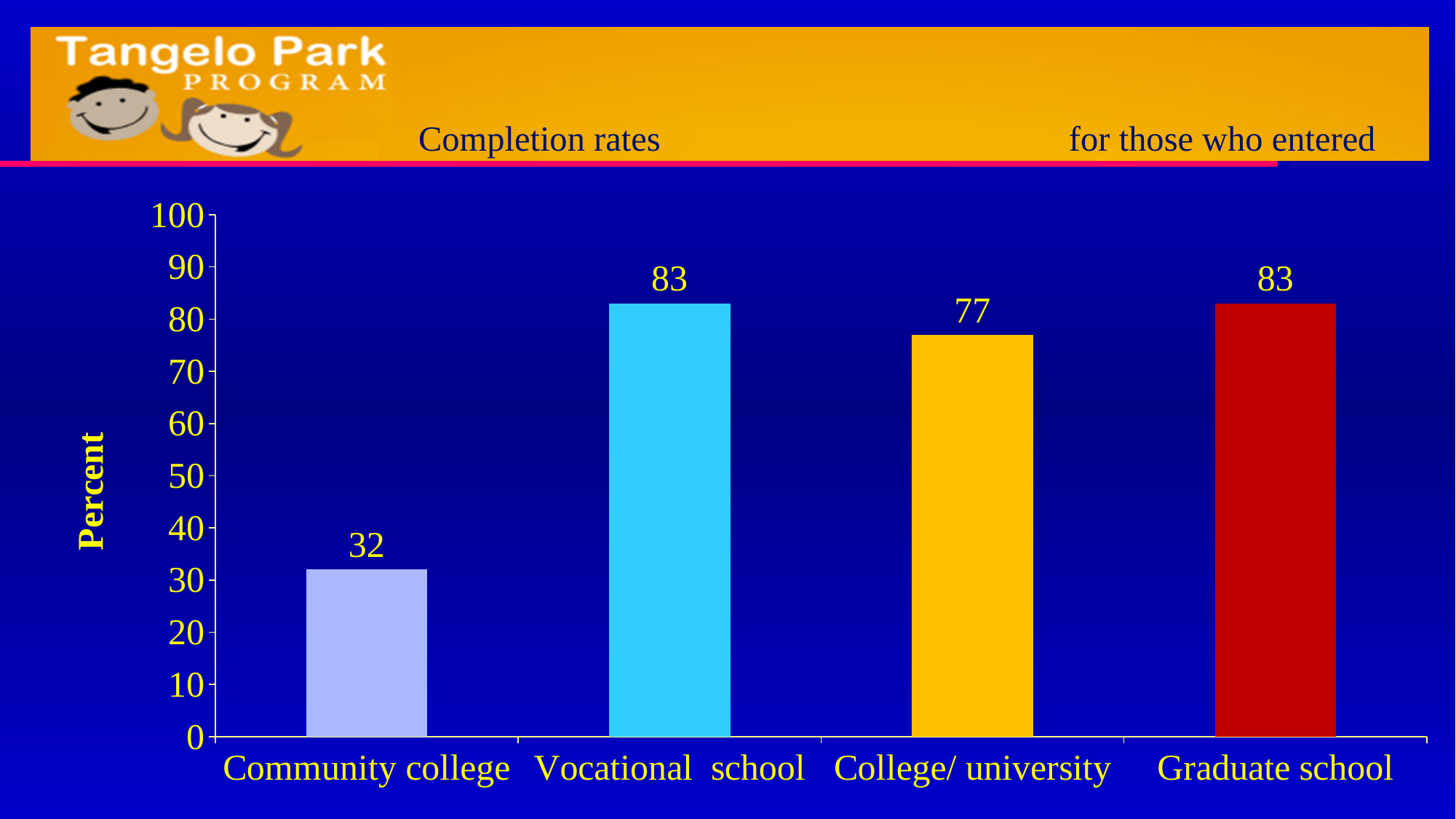
Is the completion rate for College/ university greater or less than 70? greater What is the completion rate for College/ university? 77 What is the completion rate for Graduate school? 83 What kind of chart is shown on the slide? bar chart What is the completion rate for Community college? 32 What is the difference between the completion rates for Graduate school and College/ university? 6 What is the completion rate for Vocational school? 83 Which is larger, the completion rate for College/ university or for Community college? College/ university Which category has the lowest completion rate? Community college How many categories are shown on the x axis? 4 What is the difference between the completion rates for Vocational school and Community college? 51 What is the label of the vertical axis? Percent